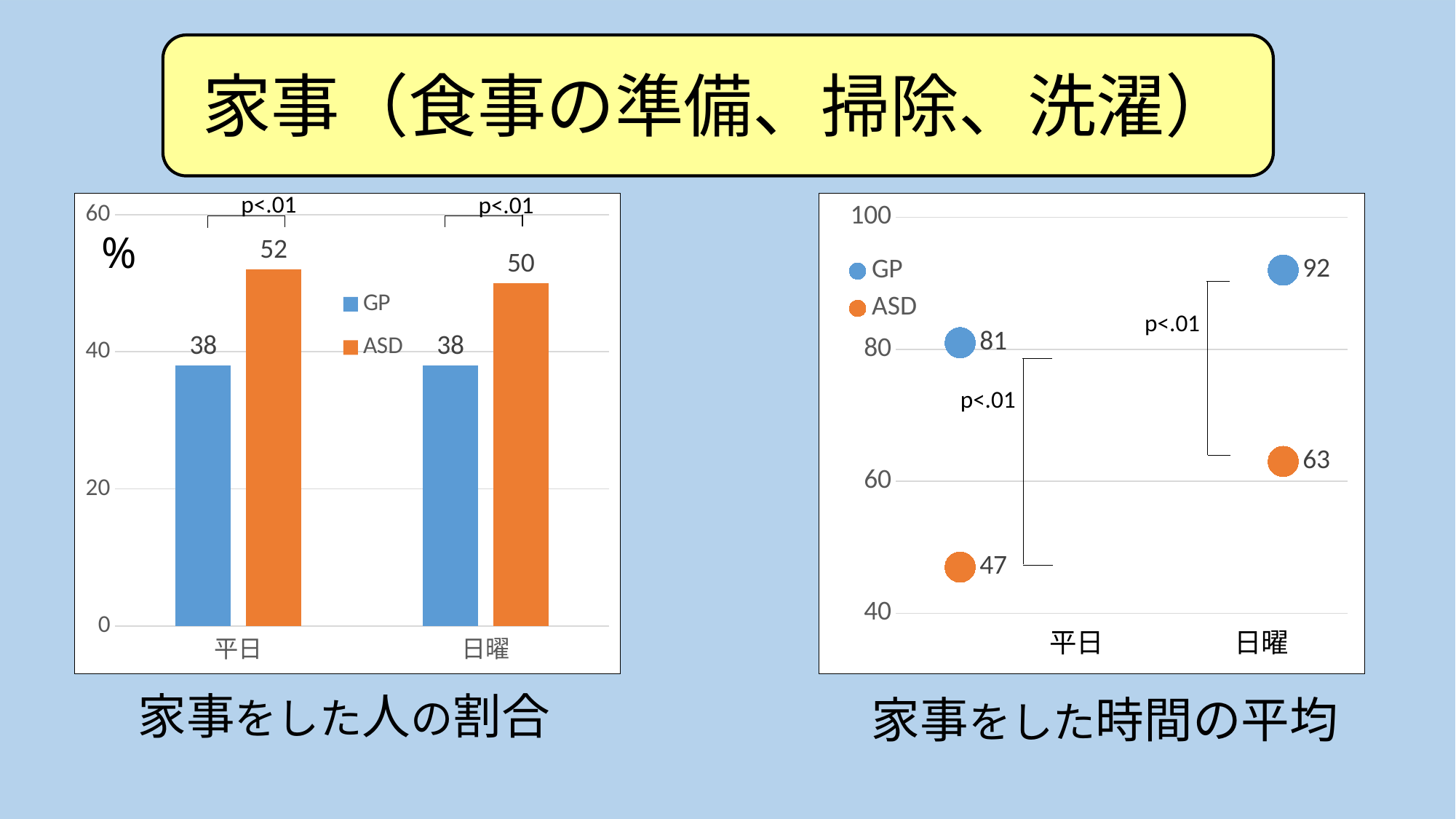
What kind of chart is the left chart (家事をした人の割合)? Bar chart In the right chart (家事をした時間の平均), what is the value for GP on 日曜? 92 In the right chart (家事をした時間の平均), which point has the lowest value? ASD on 平日 (47) In the right chart (家事をした時間の平均), what is the difference between GP and ASD on 日曜? 29 In the right chart (家事をした時間の平均), how many categories are shown on the x axis? 2 In the left chart (家事をした人の割合), what is the value for ASD on 平日? 52 In the right chart (家事をした時間の平均), what is the value for ASD on 平日? 47 In the left chart (家事をした人の割合), what is the difference between ASD and GP on 平日? 14 In the left chart (家事をした人の割合), which series has the higher value on 日曜, GP or ASD? ASD In the left chart (家事をした人の割合), what is the value for GP on 日曜? 38 In the right chart (家事をした時間の平均), what colour represents the ASD series? Orange In the left chart (家事をした人の割合), how many series does the legend list? 2